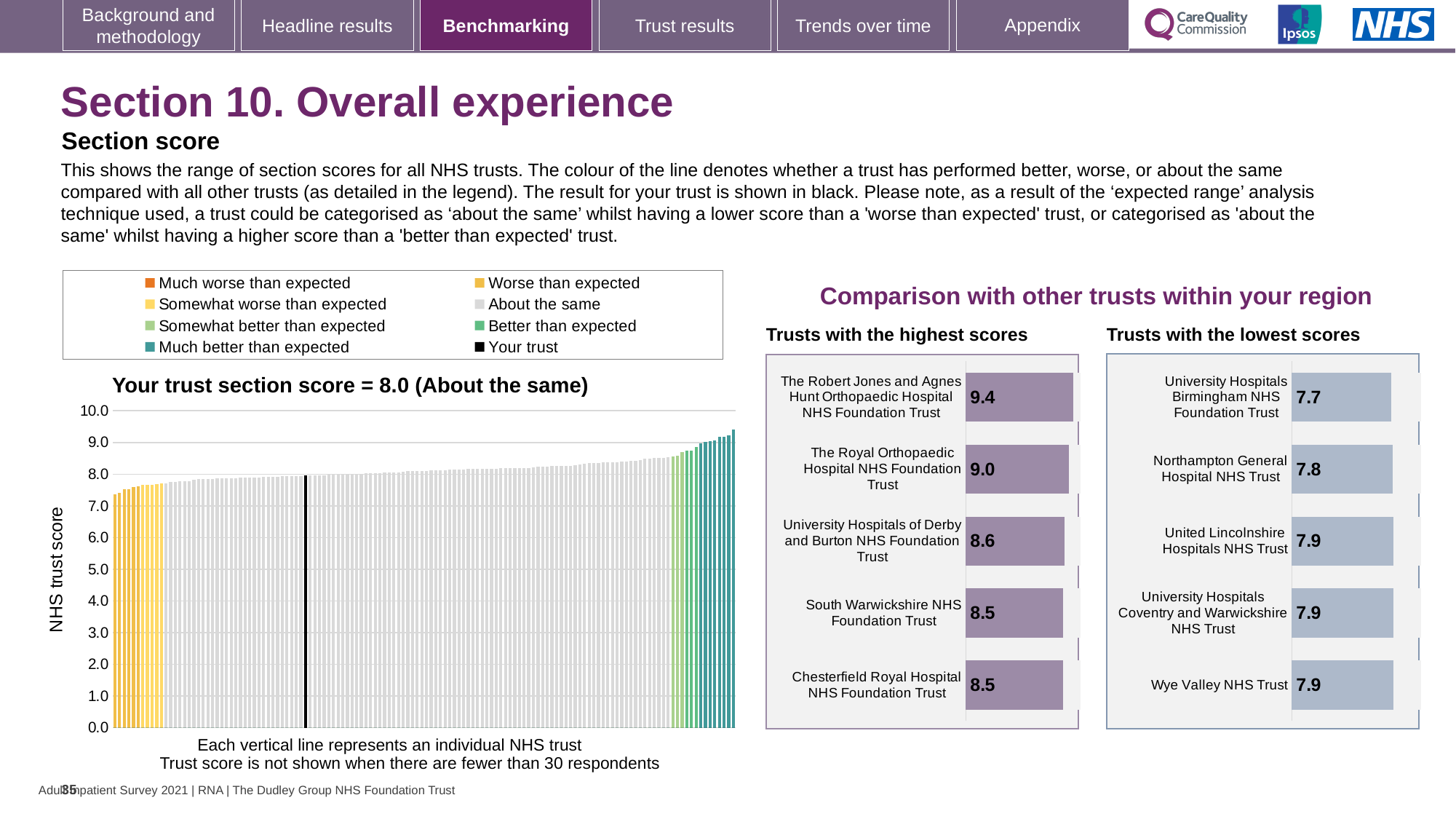
How many entries does the legend above the 'Your trust section score' chart list? 8 In the 'Your trust section score' chart, what is the section score for your trust? 8.0 In the 'Trusts with the lowest scores' chart, which trust has the lowest score? University Hospitals Birmingham NHS Foundation Trust In the 'Trusts with the highest scores' chart, what is the difference between the scores of The Robert Jones and Agnes Hunt Orthopaedic Hospital NHS Foundation Trust and University Hospitals of Derby and Burton NHS Foundation Trust? 0.8 In the 'Your trust section score' chart, what is the label on the y axis? NHS trust score In the 'Your trust section score' chart, is the value of the rightmost (highest) bar greater or less than 9.0? greater In the 'Your trust section score' chart, do the trust scores rise or fall from left to right along the x axis? rise In the 'Trusts with the highest scores' chart, which trust has the highest score? The Robert Jones and Agnes Hunt Orthopaedic Hospital NHS Foundation Trust In the 'Trusts with the highest scores' chart, what is the score for The Royal Orthopaedic Hospital NHS Foundation Trust? 9.0 In the 'Your trust section score' chart, is the value of the leftmost (lowest) bar greater or less than 8.0? less In the 'Trusts with the lowest scores' chart, how many trusts are shown? 5 In the 'Your trust section score' chart, what kind of chart is shown? bar chart